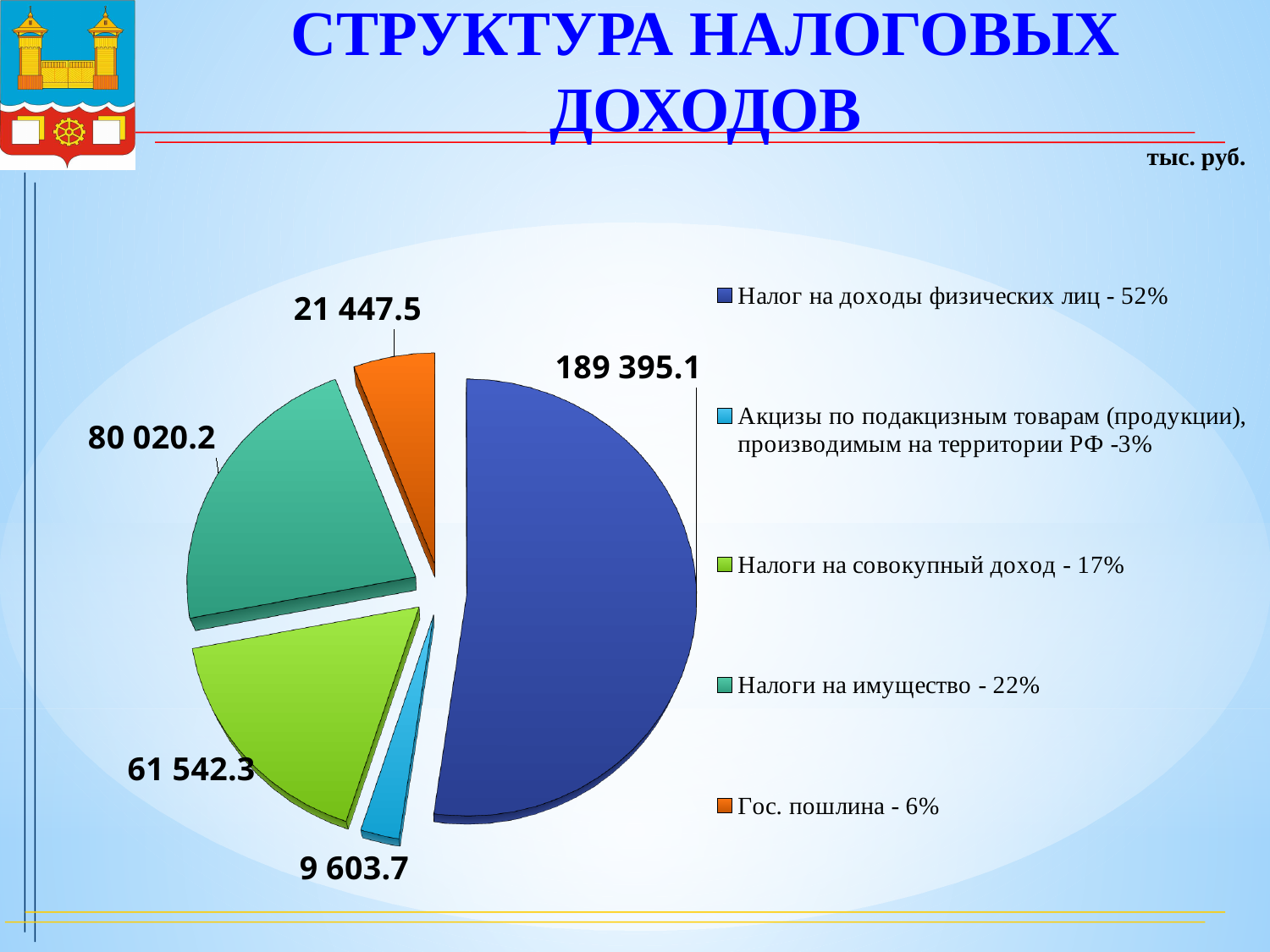
What is the difference between the values for Налоги на имущество and Налоги на совокупный доход? 18 477.9 What is the value for Акцизы по подакцизным товарам (продукции), производимым на территории РФ? 9 603.7 What share of the pie does Налоги на совокупный доход represent, according to the legend? 17% Which category has the largest slice of the pie? Налог на доходы физических лиц What is the value for Налог на доходы физических лиц? 189 395.1 What is the value for Гос. пошлина? 21 447.5 How many slices does the pie chart have? 5 What unit of measurement is indicated for the chart values? тыс. руб. What is the value for Налоги на имущество? 80 020.2 Which category has the smallest slice of the pie? Акцизы по подакцизным товарам (продукции), производимым на территории РФ What type of chart is shown on the slide? pie chart Which is larger, the value for Гос. пошлина or the value for Акцизы по подакцизным товарам? Гос. пошлина